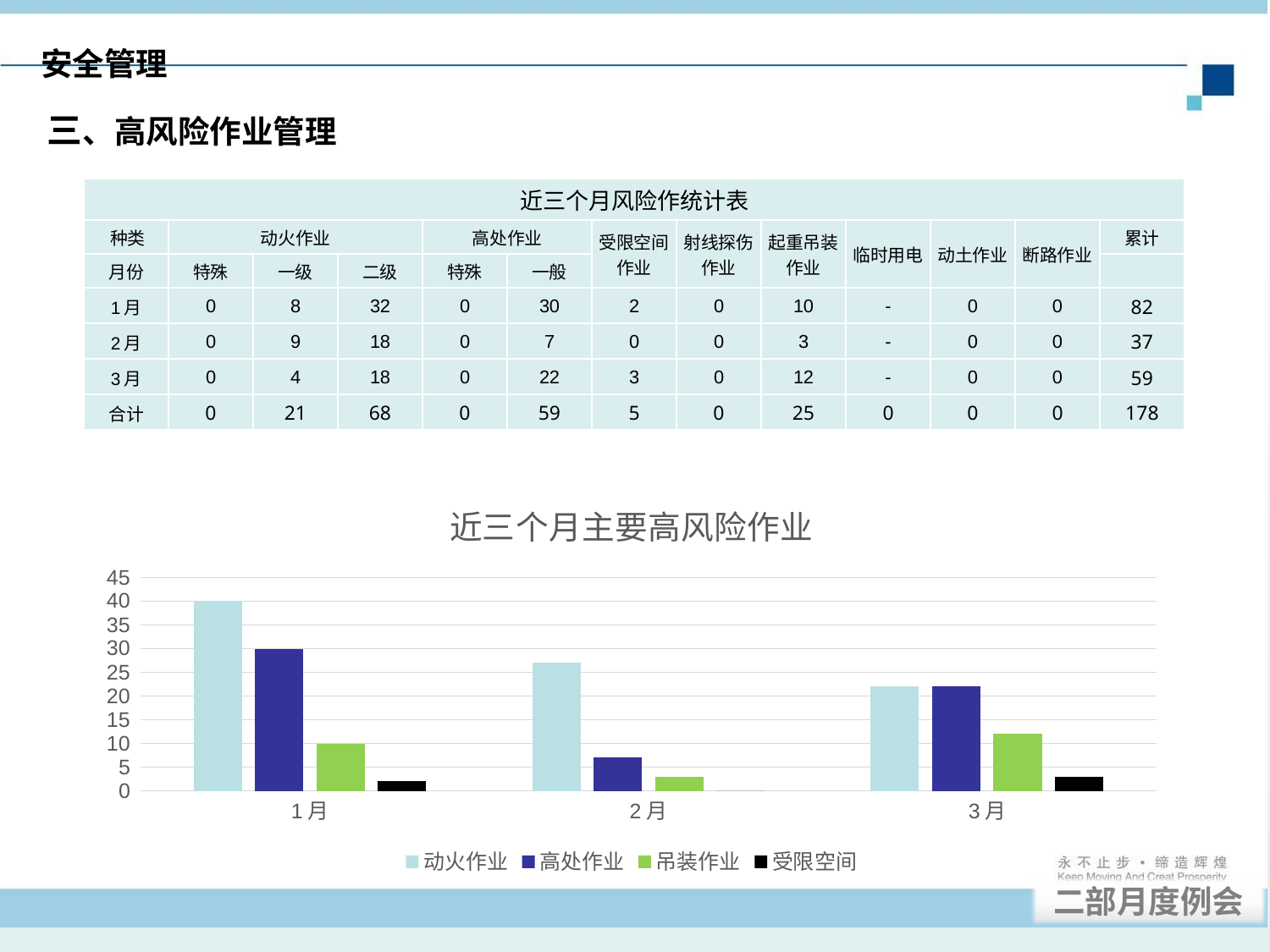
What type of chart is shown on the slide? bar chart How many months are shown on the x axis of the chart? 3 In which month is 动火作业 highest? 1月 What is the title of the chart? 近三个月主要高风险作业 In which month is 高处作业 lowest? 2月 What is the value for 动火作业 in 1月? 40 How many series does the chart legend list? 4 What is the value for 吊装作业 in 1月? 10 Which is larger in 2月, 动火作业 or 高处作业? 动火作业 Is the value for 动火作业 in 2月 greater or less than 25? greater Is the value for 受限空间 in 3月 greater or less than 5? less What is the value for 高处作业 in 1月? 30